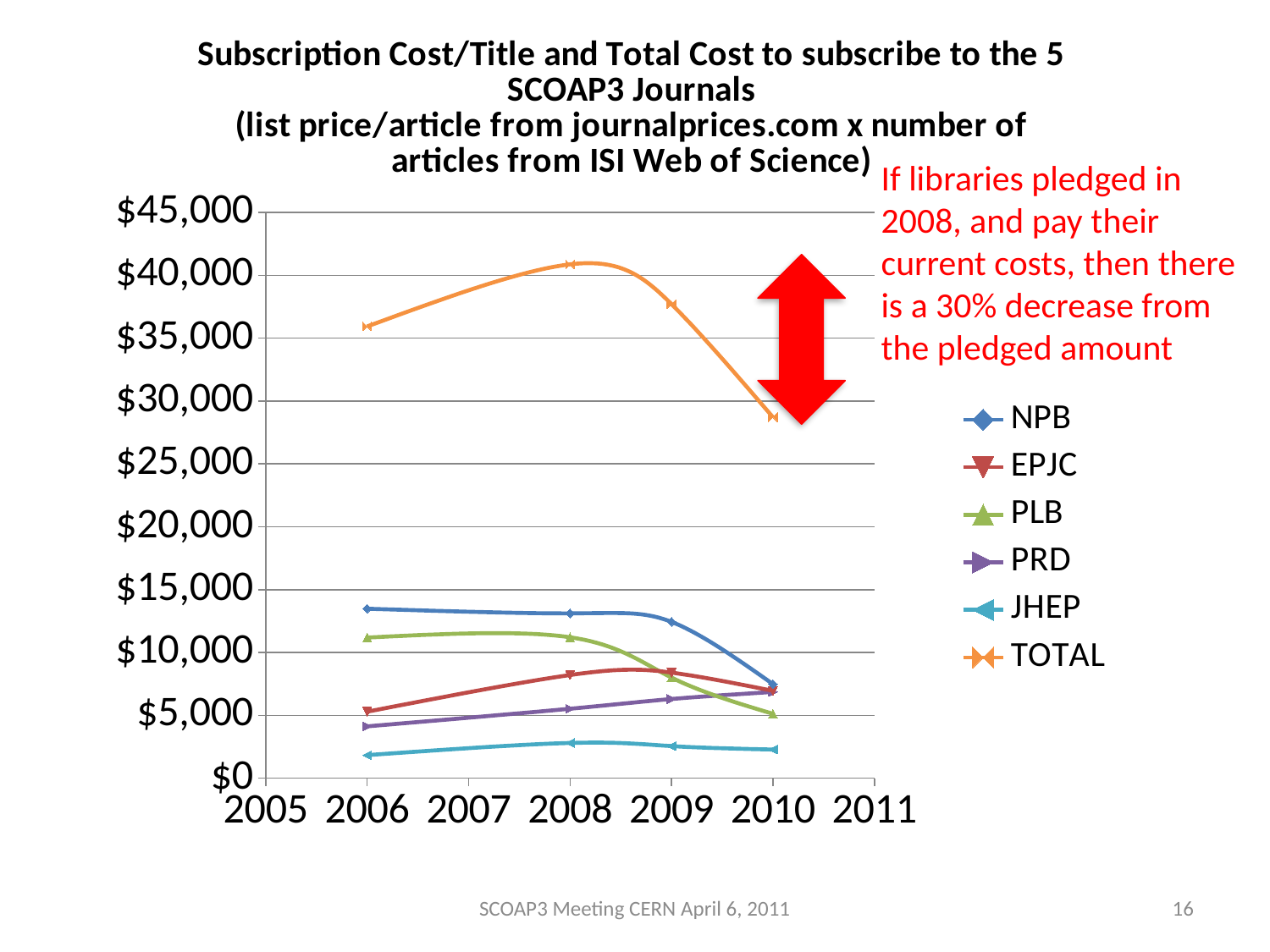
Is the NPB value for 2006 greater or less than $15,000? less What colour is the TOTAL line in the chart? orange Does the PRD series rise or fall from 2006 to 2010? rise How many series does the legend list? 6 Does the TOTAL series rise or fall from 2008 to 2010? fall Is the TOTAL value for 2010 greater or less than $30,000? less Which series has the highest values throughout the chart? TOTAL Which series has the lowest values throughout the chart? JHEP Is the TOTAL value for 2008 greater or less than $40,000? greater In 2006, which is larger, the NPB value or the PLB value? NPB What kind of chart is shown on the slide? line chart